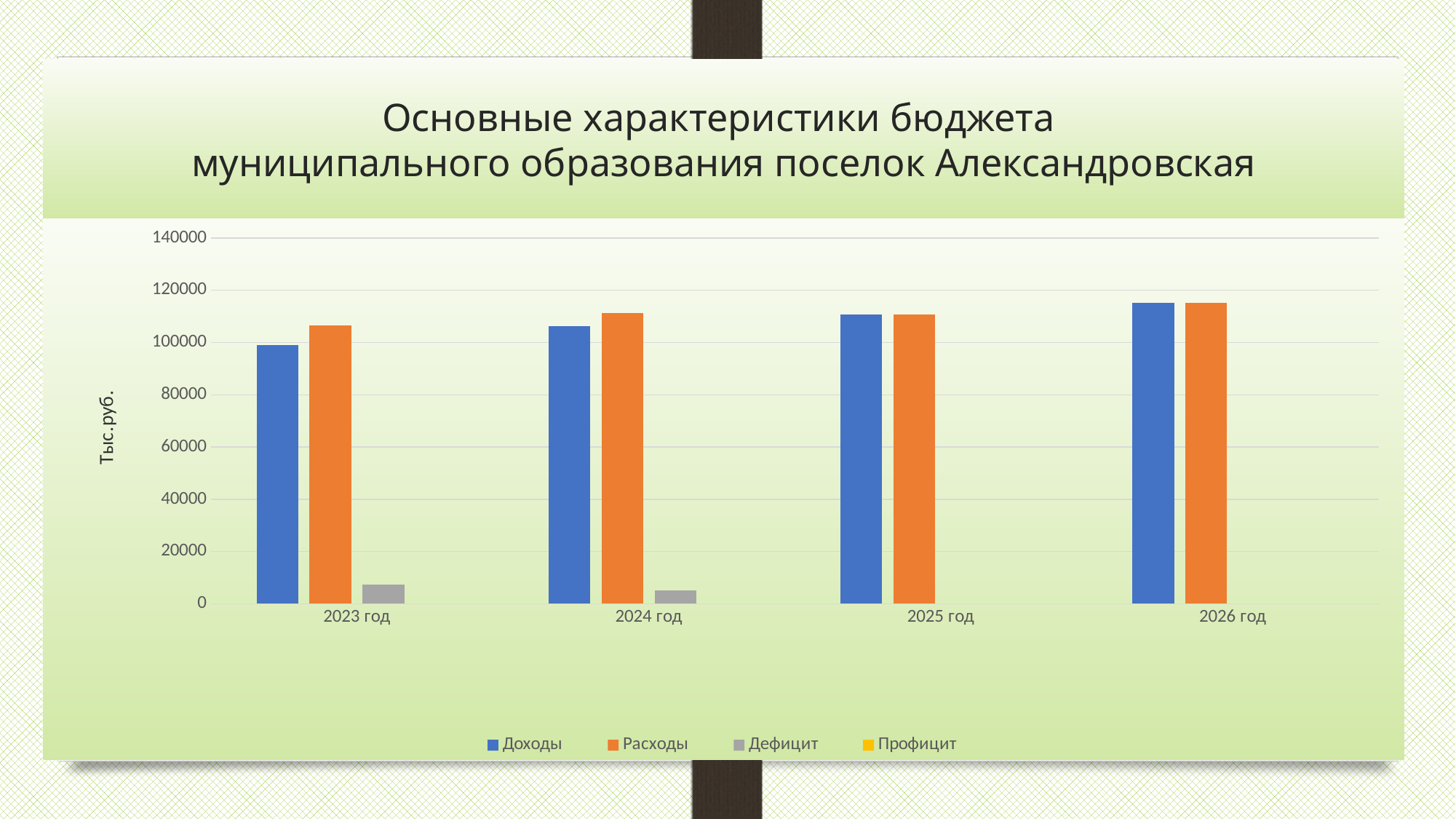
In which year is Доходы the lowest? 2023 год Do the Доходы values rise or fall from 2023 год to 2026 год? rise How many years (categories) are shown on the x axis? 4 How many series does the legend list? 4 In 2023 год, which is larger: Доходы or Расходы? Расходы What kind of chart is shown on the slide? bar chart Is the value for Расходы in 2024 год greater or less than 120000? less In which year is Доходы the highest? 2026 год Is the value for Доходы in 2026 год greater or less than 100000? greater Is the value for Дефицит in 2023 год greater or less than 20000? less What is the label on the vertical axis? Тыс. руб.